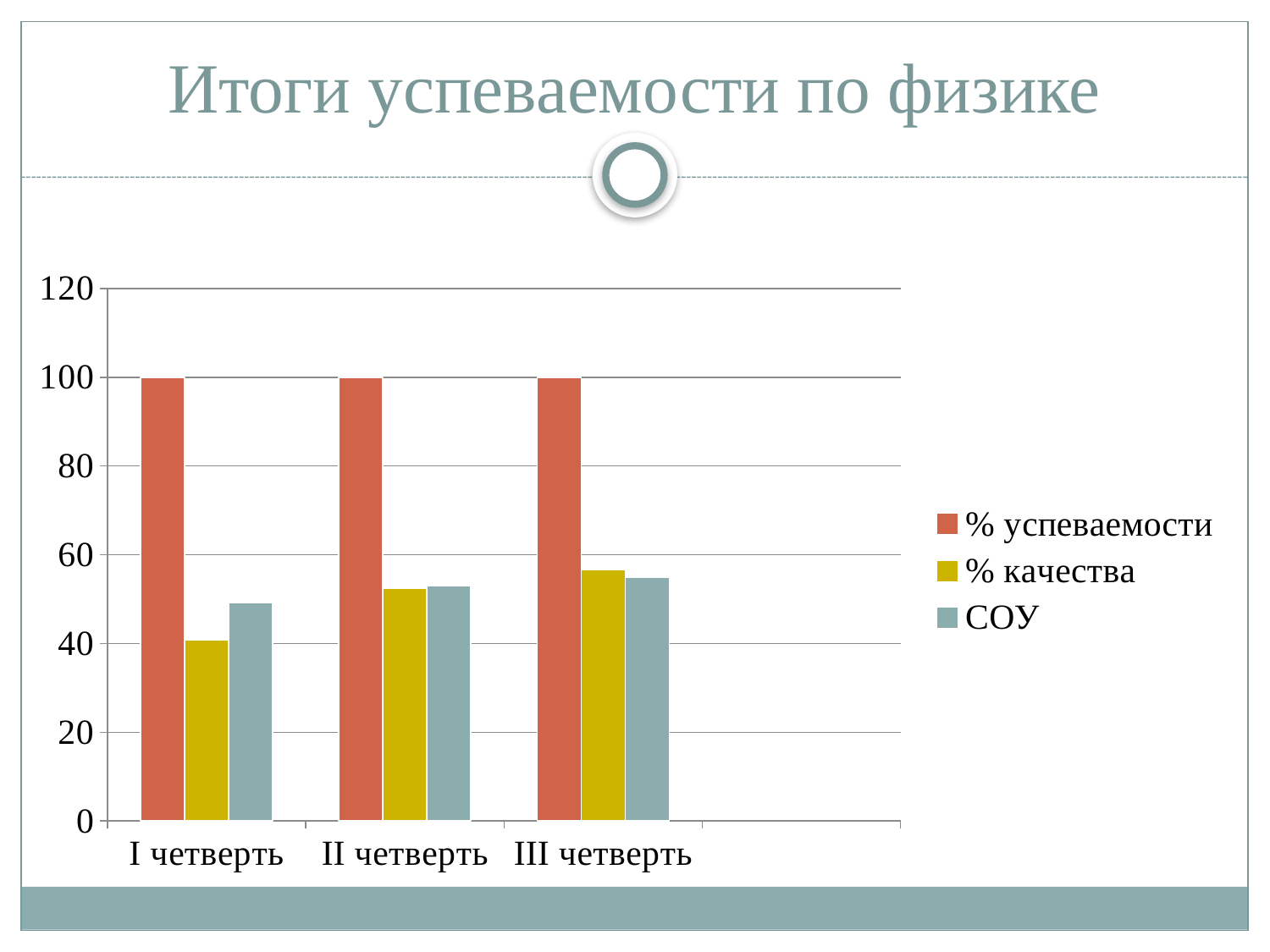
For I четверть, which is larger: % качества or СОУ? СОУ What is the value of % успеваемости for I четверть? 100 Does % качества rise or fall from I четверть to III четверть? rise Is the value of СОУ for II четверть greater or less than 40? greater Is the value of % качества for III четверть greater or less than 80? less What kind of chart is shown on the slide? bar chart How many categories are shown on the x axis? 3 Is the value of % качества for I четверть greater or less than 60? less In which quarter is % качества the lowest? I четверть What is the value of % успеваемости for III четверть? 100 How many series does the legend list? 3 What is the title of the chart on the slide? Итоги успеваемости по физике